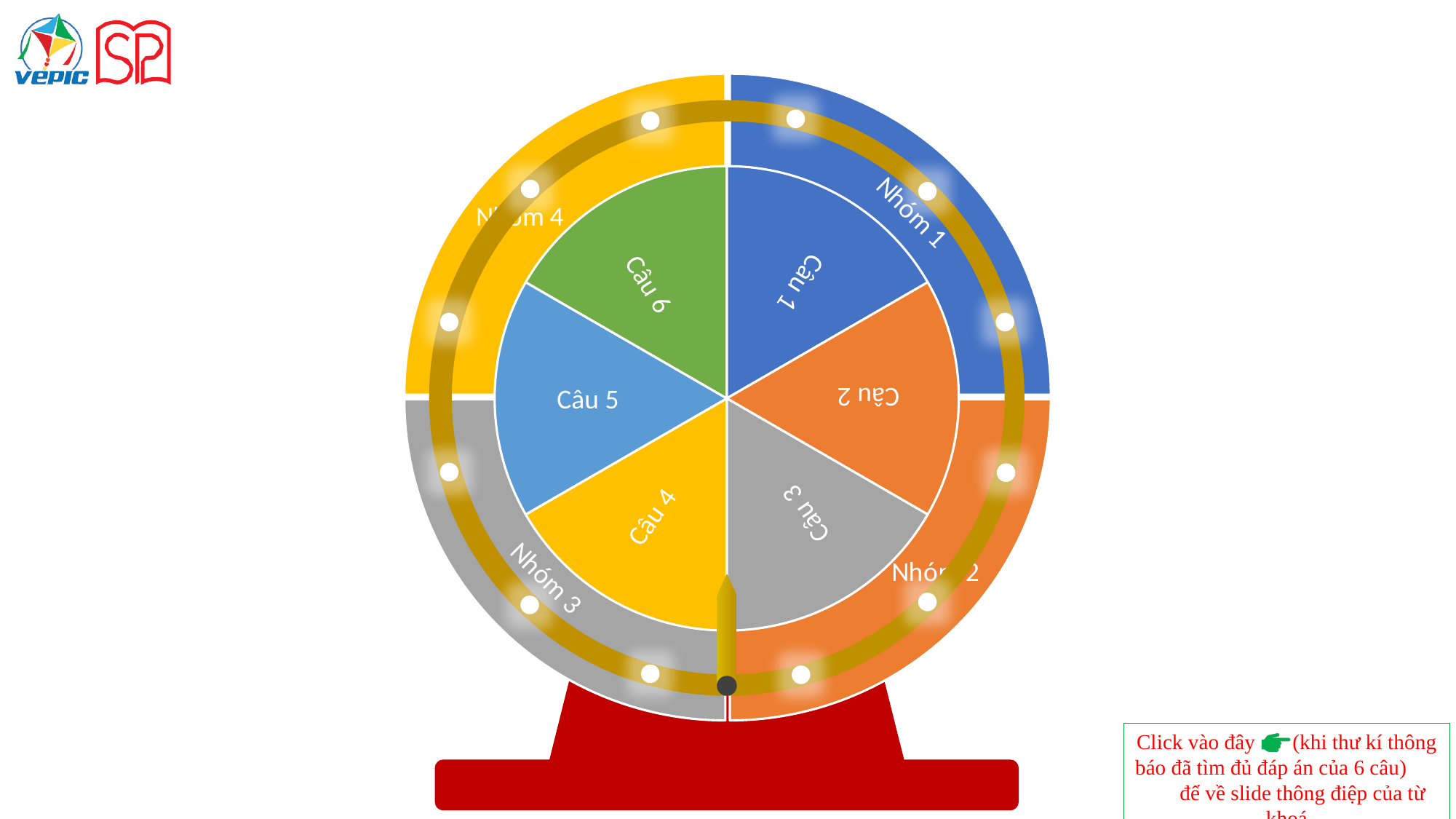
What colour is the slice labelled Câu 1 in the inner wheel? blue What is the label of the green slice in the inner wheel? Câu 6 Which slice of the inner wheel is labelled Câu 4? the yellow slice What is the label of the outer ring segment coloured grey? Nhóm 3 How many segments does the outer ring of the wheel have? 4 What is the label of the outer ring segment coloured yellow? Nhóm 4 What kind of chart is the inner wheel in the centre of the slide? pie chart How many slices does the inner wheel have? 6